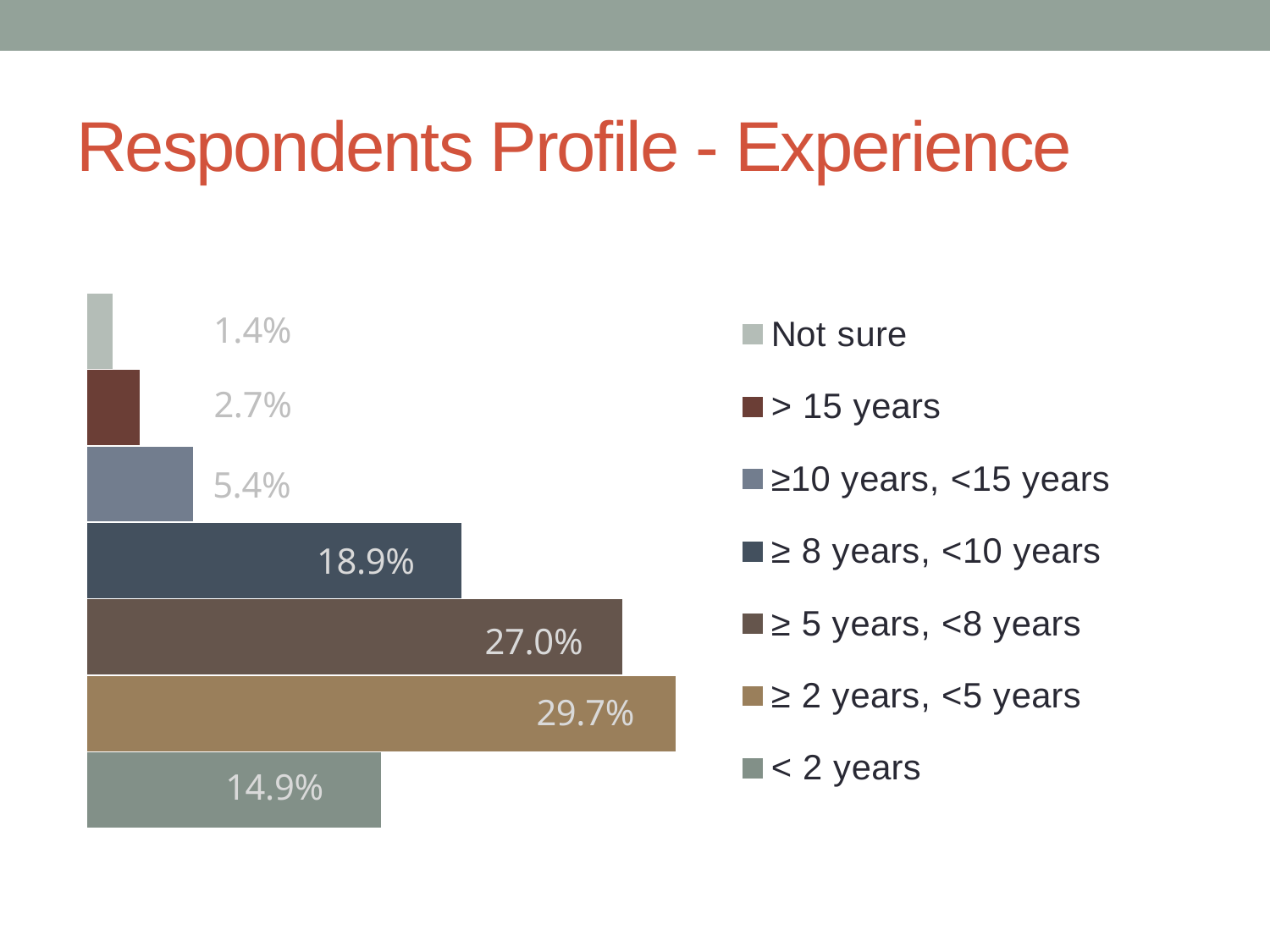
Which experience category has the lowest percentage of respondents? Not sure What percentage of respondents have < 2 years of experience? 14.9% What type of chart is shown on the slide? Bar chart Which experience category has the highest percentage of respondents? ≥ 2 years, <5 years What percentage of respondents have > 15 years of experience? 2.7% What is the title of the slide containing the chart? Respondents Profile - Experience What percentage of respondents answered 'Not sure' about their experience? 1.4% What is the difference in percentage points between the ≥ 2 years, <5 years category and the ≥ 5 years, <8 years category? 2.7 What percentage of respondents have ≥ 2 years, <5 years of experience? 29.7% Which has a larger share of respondents: ≥ 8 years, <10 years or < 2 years? ≥ 8 years, <10 years How many experience categories are shown in the chart? 7 What is the combined percentage of respondents with ≥10 years, <15 years and > 15 years of experience? 8.1%